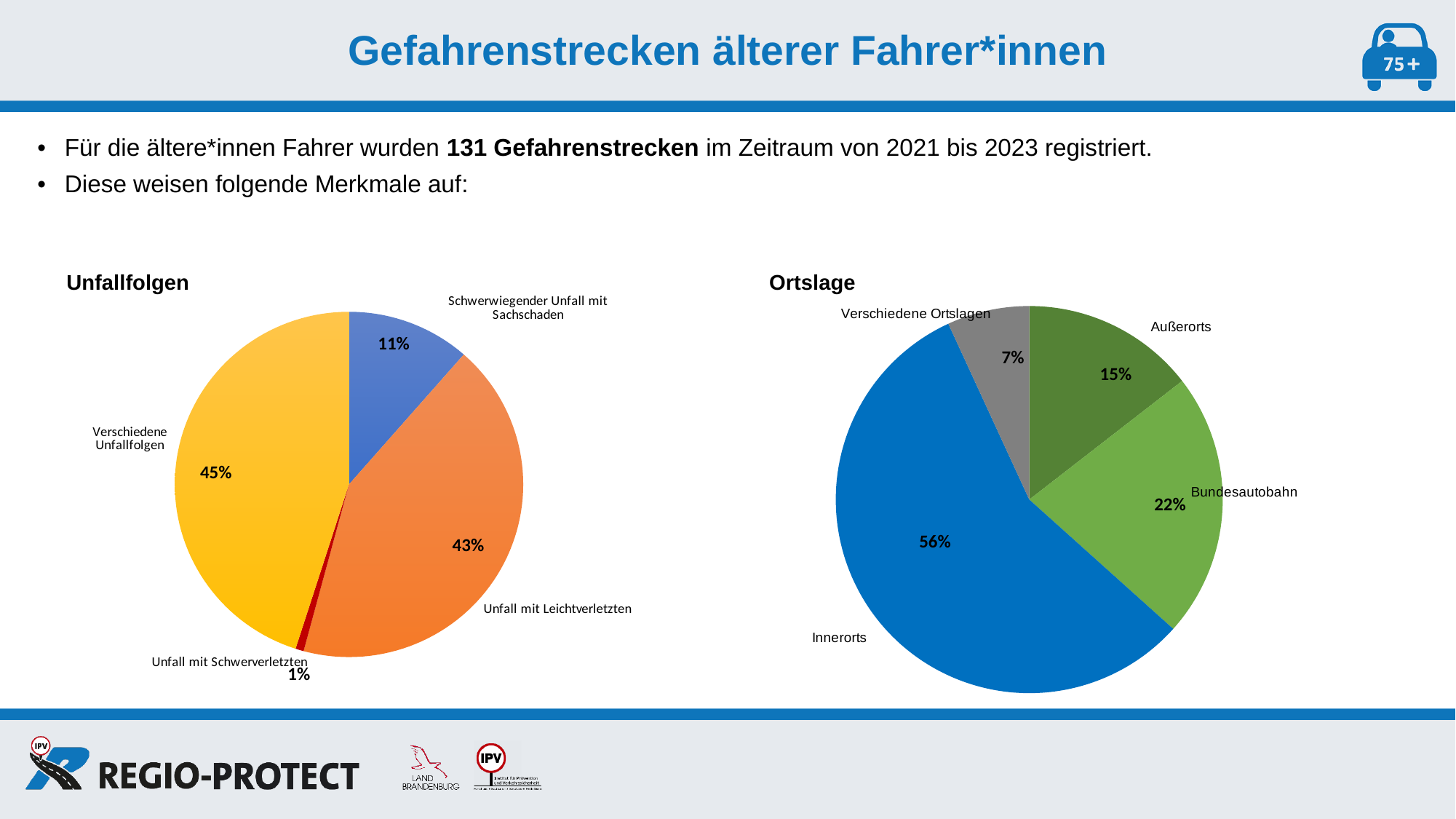
In the Unfallfolgen chart, how many categories are shown? 4 In the Ortslage chart, which category has the smallest share? Verschiedene Ortslagen In the Unfallfolgen chart, what share does Verschiedene Unfallfolgen have? 45% In the Ortslage chart, what share does Innerorts have? 56% In the Unfallfolgen chart, which category has the largest share? Verschiedene Unfallfolgen What type of chart is the Ortslage chart? Pie chart In the Unfallfolgen chart, what is the difference between Verschiedene Unfallfolgen and Schwerwiegender Unfall mit Sachschaden? 34 percentage points In the Ortslage chart, what is the value for Bundesautobahn? 22% In the Ortslage chart, which is larger, Außerorts or Bundesautobahn? Bundesautobahn In the Unfallfolgen chart, which category has the smallest share? Unfall mit Schwerverletzten In the Ortslage chart, what is the difference between Innerorts and Außerorts? 41 percentage points In the Unfallfolgen chart, what is the value for Unfall mit Leichtverletzten? 43%